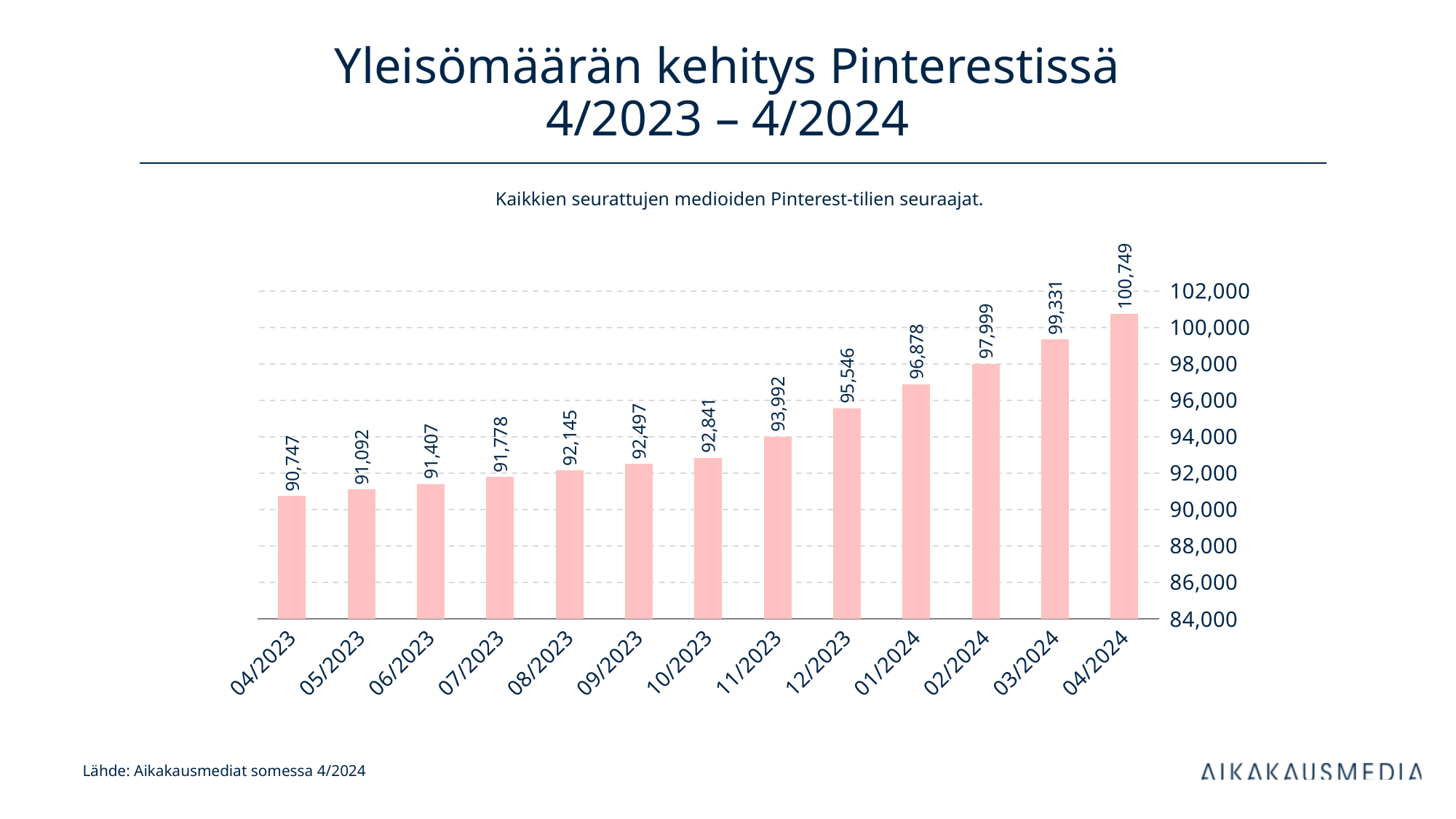
What is the value for 04/2024? 100,749 What is the value for 04/2023? 90,747 What is the difference between the values for 03/2024 and 02/2024? 1,332 How many months are shown on the x axis? 13 Do the values rise or fall from 04/2023 to 04/2024? rise What kind of chart is shown on the slide? bar chart Which month has the highest value? 04/2024 What is the value for 11/2023? 93,992 Which is larger, the value for 09/2023 or the value for 12/2023? 12/2023 What is the difference between the values for 04/2024 and 04/2023? 10,002 Which month has the lowest value? 04/2023 Is the value for 01/2024 greater or less than 96,000? greater